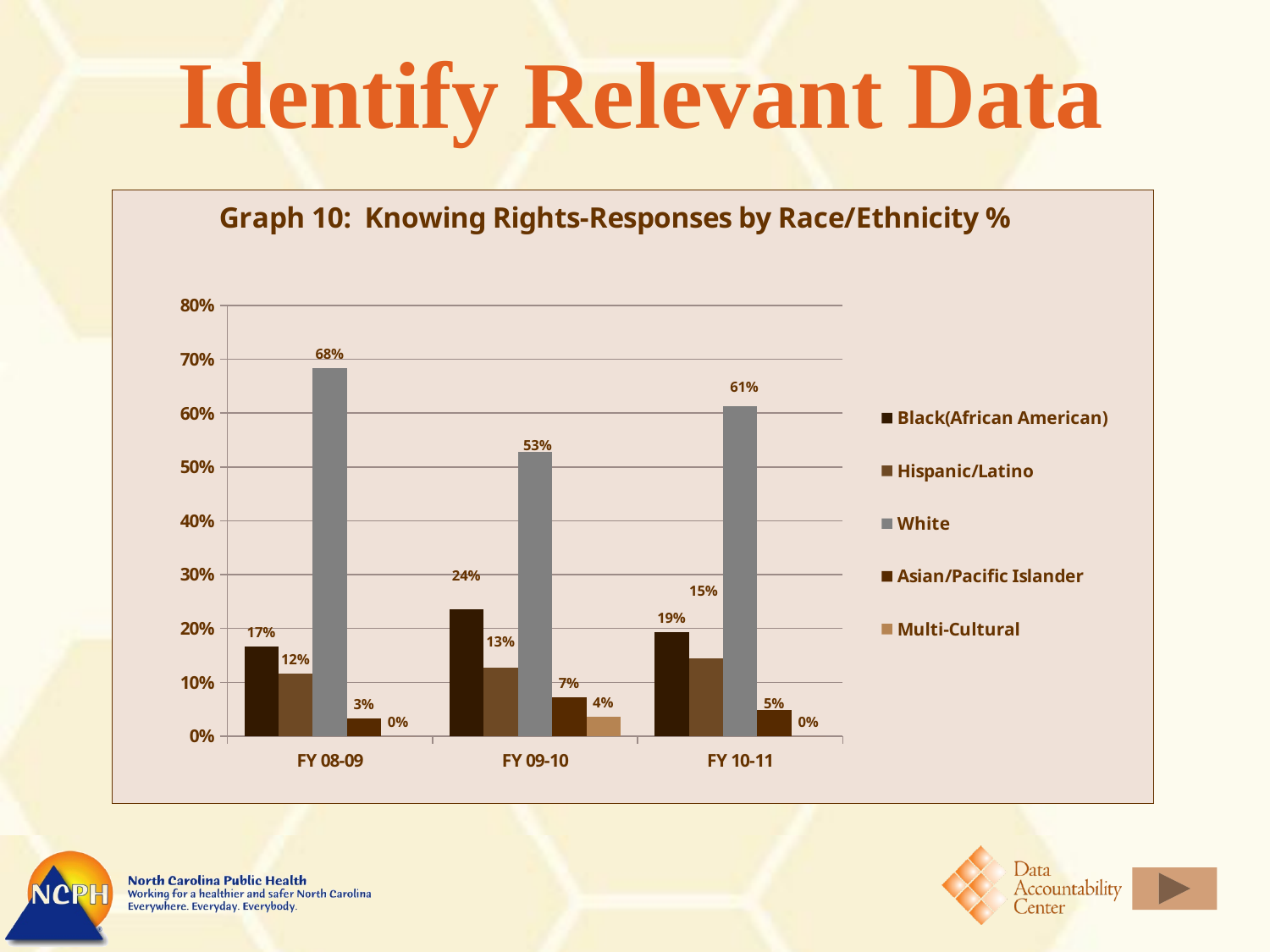
In which fiscal year is the White value highest? FY 08-09 What is the difference between the White values in FY 08-09 and FY 09-10? 15% What is the value for Hispanic/Latino in FY 10-11? 15% What kind of chart is shown on the slide? Bar chart What is the value for Multi-Cultural in FY 09-10? 4% How many fiscal years are shown on the x axis? 3 What is the value for Asian/Pacific Islander in FY 09-10? 7% What is the value for Black(African American) in FY 09-10? 24% What is the value for White in FY 08-09? 68% In which fiscal year is the Black(African American) value lowest? FY 08-09 How many series does the legend list? 5 Which is larger: the Hispanic/Latino value in FY 09-10 or the Black(African American) value in FY 10-11? Black(African American) in FY 10-11